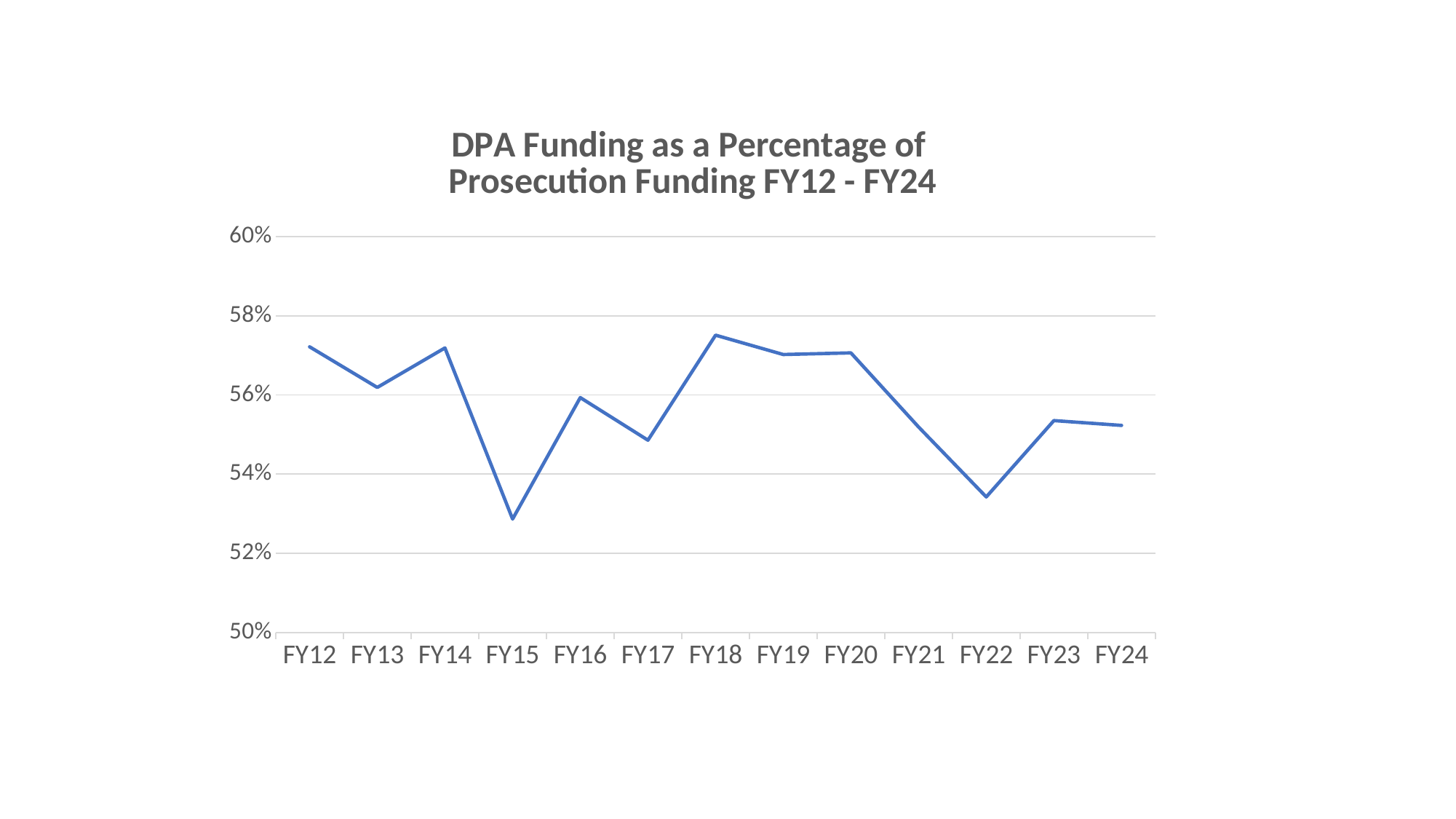
What kind of chart is shown on the slide? line chart How many fiscal years are plotted on the x axis? 13 What is the title of the chart? DPA Funding as a Percentage of Prosecution Funding FY12 - FY24 Is the value for FY18 greater or less than 58%? less Is the value for FY15 greater or less than 54%? less Which is larger, the value for FY17 or the value for FY18? FY18 Is the value for FY12 greater or less than 56%? greater Do the values rise or fall from FY20 to FY22? fall Which is larger, the value for FY14 or the value for FY15? FY14 Which fiscal year has the highest value? FY18 Which fiscal year has the lowest value? FY15